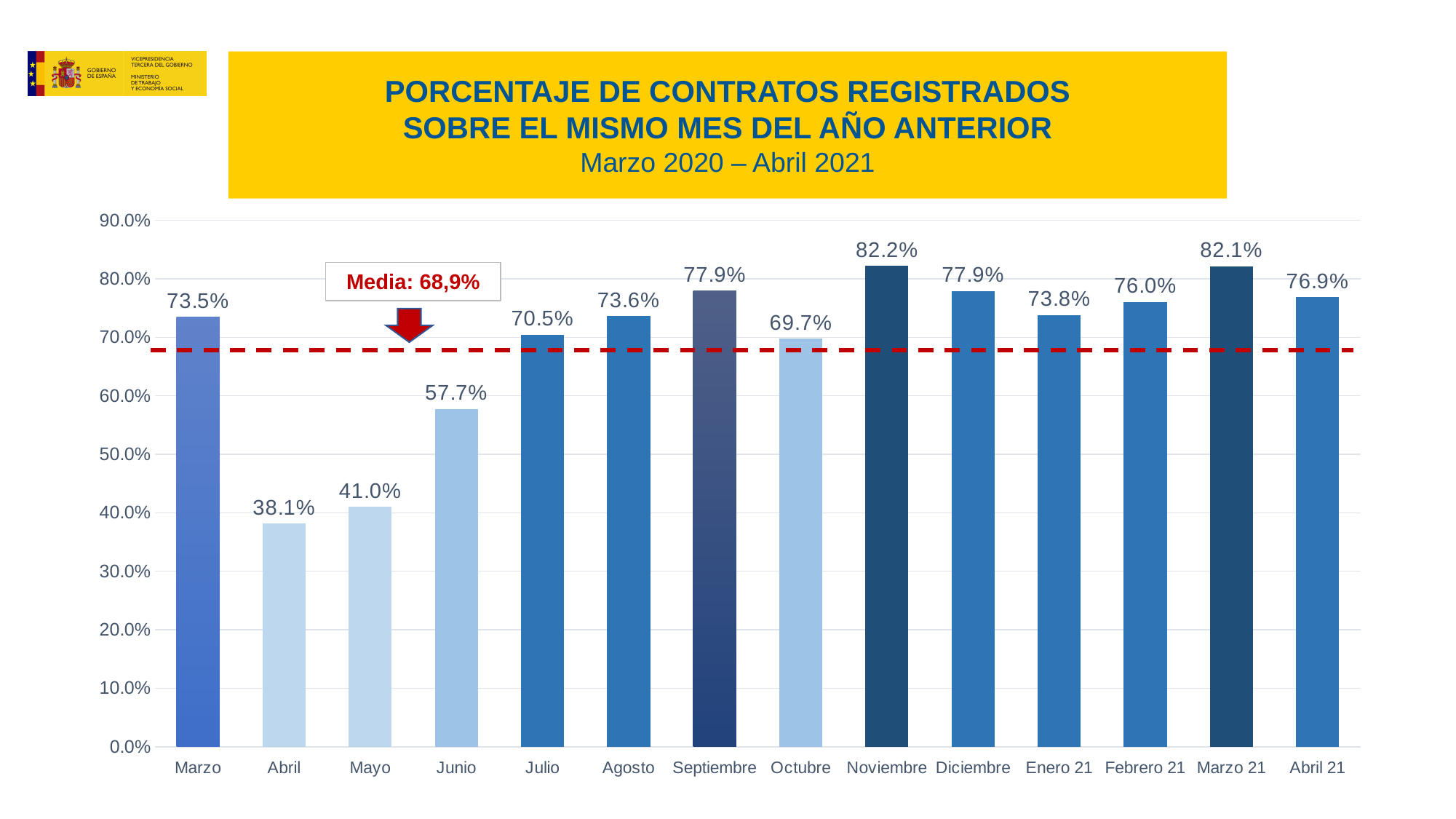
How many months are shown on the x axis? 14 Do the values rise or fall from Abril to Junio? rise What average value (Media) is indicated by the dashed red line? 68,9% Which month has the lowest value? Abril Is the value for Junio greater or less than 60.0%? less What is the value for Noviembre? 82.2% What is the value for Febrero 21? 76.0% What is the difference between the values for Junio and Mayo? 16.7% Which month has the highest value? Noviembre What is the value for Abril? 38.1% Which is larger, the value for Marzo or the value for Octubre? Marzo What kind of chart is shown on the slide? bar chart